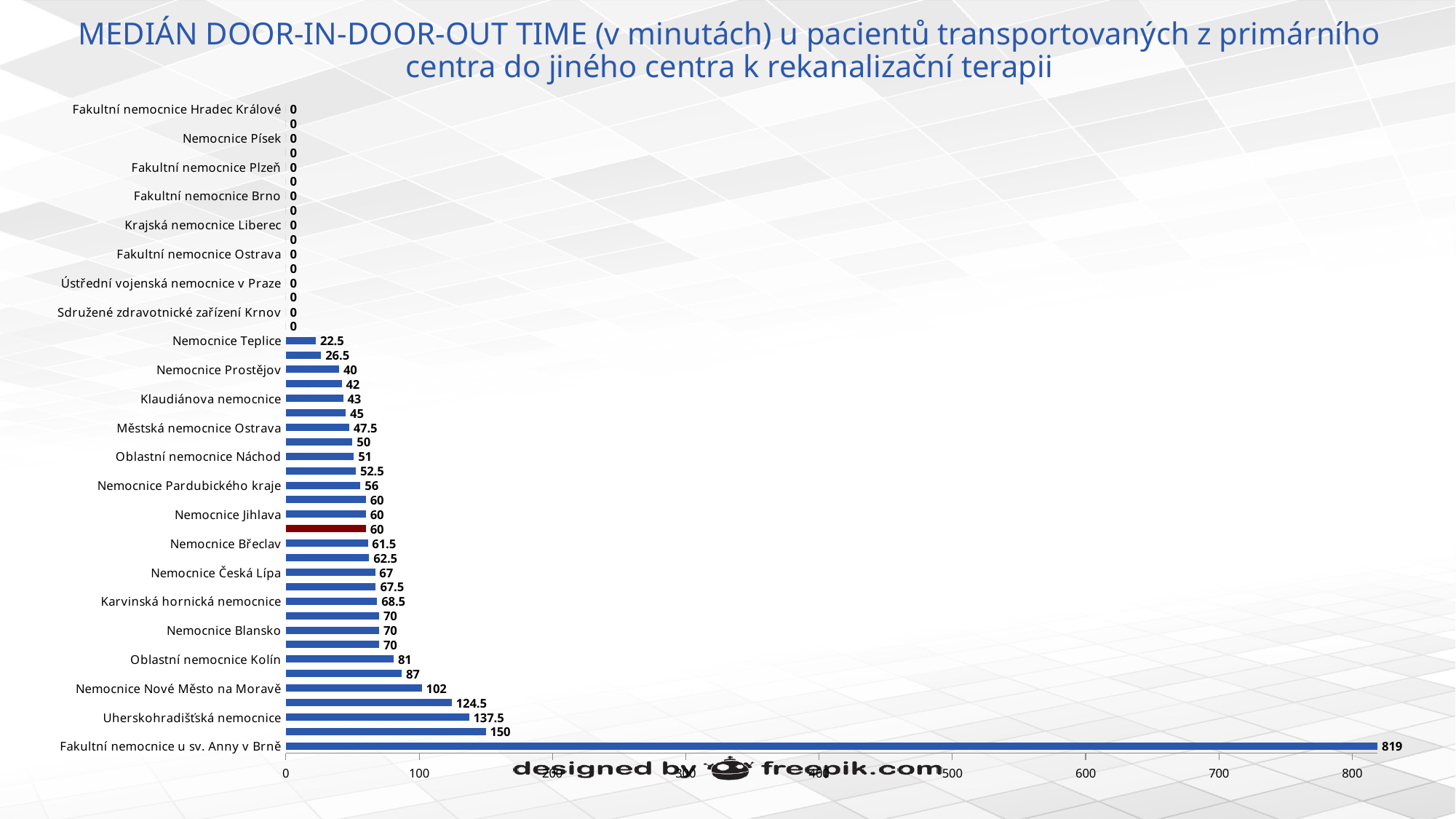
What is the median door-in-door-out time for Fakultní nemocnice u sv. Anny v Brně? 819 What is the value shown for Nemocnice Teplice? 22.5 Is the value for Oblastní nemocnice Kolín greater or less than 100? less What is the value shown for Uherskohradišťská nemocnice? 137.5 What is the value shown for Nemocnice Nové Město na Moravě? 102 What value is labelled on the single red bar in the chart? 60 Which has a larger value, Nemocnice Blansko or Nemocnice Jihlava? Nemocnice Blansko What is the difference between the values for Nemocnice Nové Město na Moravě and Oblastní nemocnice Kolín? 21 What is the difference between the values for Fakultní nemocnice u sv. Anny v Brně and Uherskohradišťská nemocnice? 681.5 What is the value shown for Karvinská hornická nemocnice? 68.5 What kind of chart is shown on the slide? bar chart Which hospital has the highest median door-in-door-out time? Fakultní nemocnice u sv. Anny v Brně